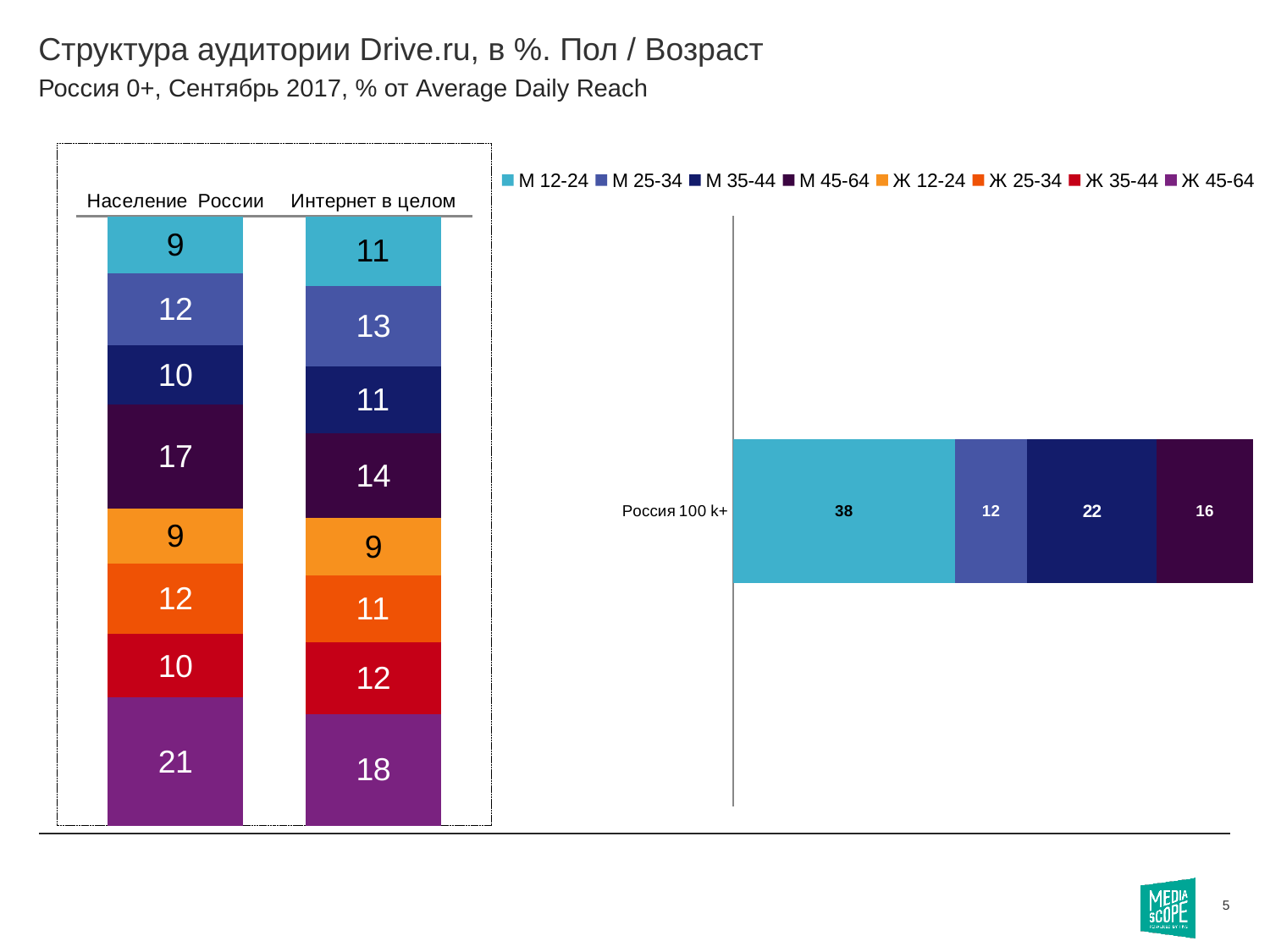
In the right-hand chart, what is the value of the М 12-24 segment for Россия 100 k+? 38 In the right-hand chart, what is the difference between the М 12-24 and М 45-64 segments for Россия 100 k+? 22 In the right-hand chart, which segment of the Россия 100 k+ bar is the largest? М 12-24 In the right-hand chart, what is the total of the Россия 100 k+ stacked bar? 88 In the left-hand chart, what is the value of the top (М 12-24) segment for Интернет в целом? 11 How many series does the legend list? 8 What kind of chart is shown on the right-hand side of the slide? Stacked bar chart In the left-hand chart, which is larger: the М 45-64 segment for Население России or for Интернет в целом? Население России In the left-hand chart, what is the value of the bottom (Ж 45-64) segment for Население России? 21 In the left-hand chart, what is the difference between the Ж 45-64 segments for Население России and Интернет в целом? 3 In the right-hand chart, which segment of the Россия 100 k+ bar is the smallest? М 25-34 In the right-hand chart, what is the value of the М 35-44 segment for Россия 100 k+? 22